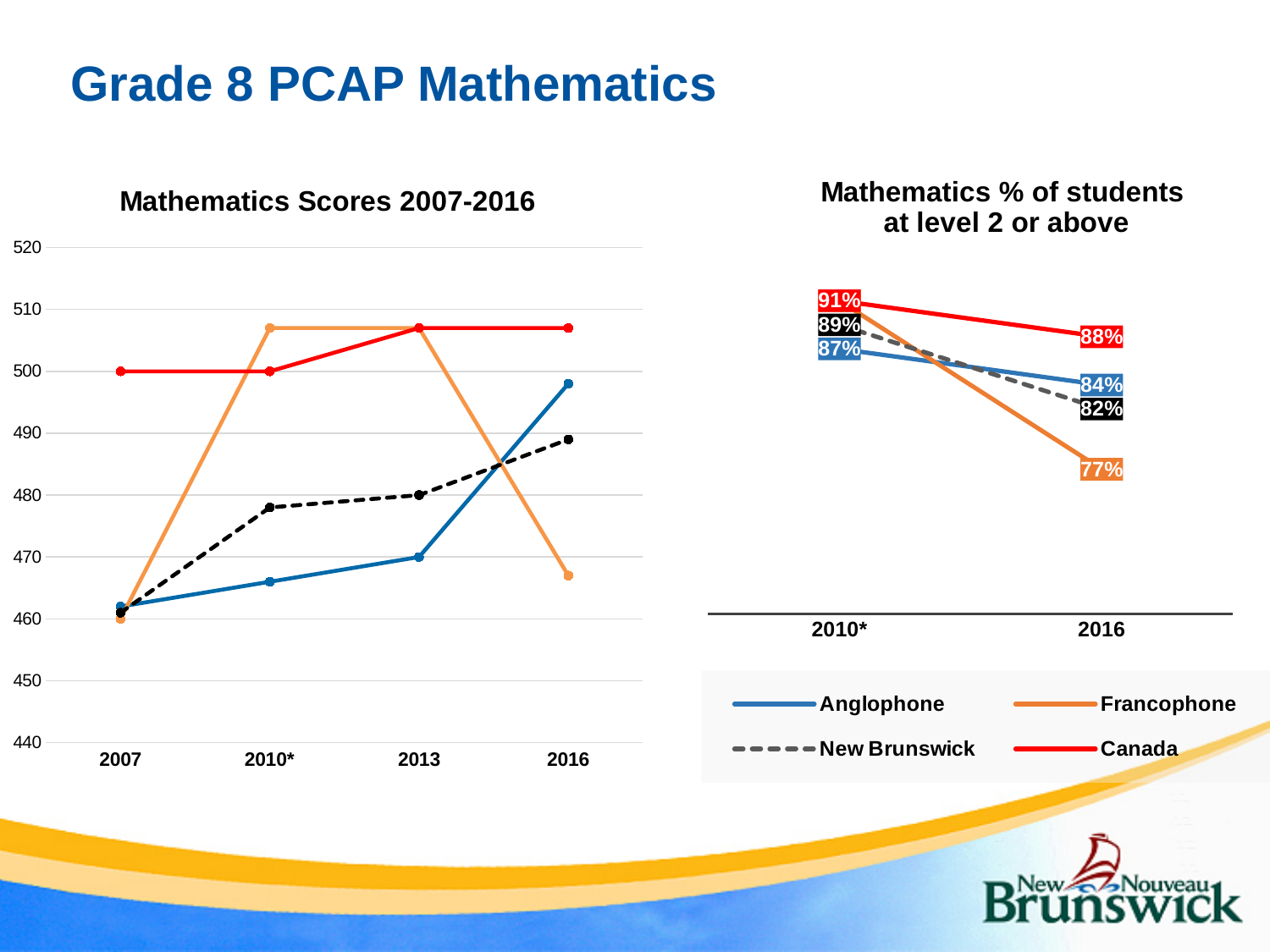
In the 'Mathematics % of students at level 2 or above' chart, what is the value for Francophone in 2016? 77% In the 'Mathematics % of students at level 2 or above' chart, what is the difference between Canada and Anglophone in 2016? 4 percentage points How many years are shown on the x axis of the 'Mathematics Scores 2007-2016' chart? 4 In the 'Mathematics Scores 2007-2016' chart, is the value for Anglophone in 2016 greater or less than 490? greater In the 'Mathematics % of students at level 2 or above' chart, what is the value for Canada in 2010*? 91% What kind of chart is 'Mathematics Scores 2007-2016'? line chart In the 'Mathematics % of students at level 2 or above' chart, what is the value for Canada in 2016? 88% In the 'Mathematics % of students at level 2 or above' chart, which is larger in 2016, Anglophone or New Brunswick? Anglophone In the 'Mathematics % of students at level 2 or above' chart, which series has the lowest value in 2016? Francophone In the 'Mathematics % of students at level 2 or above' chart, does the Canada line rise or fall from 2010* to 2016? fall In the 'Mathematics Scores 2007-2016' chart, which series has the highest score in 2016? Canada How many series does the legend list? 4